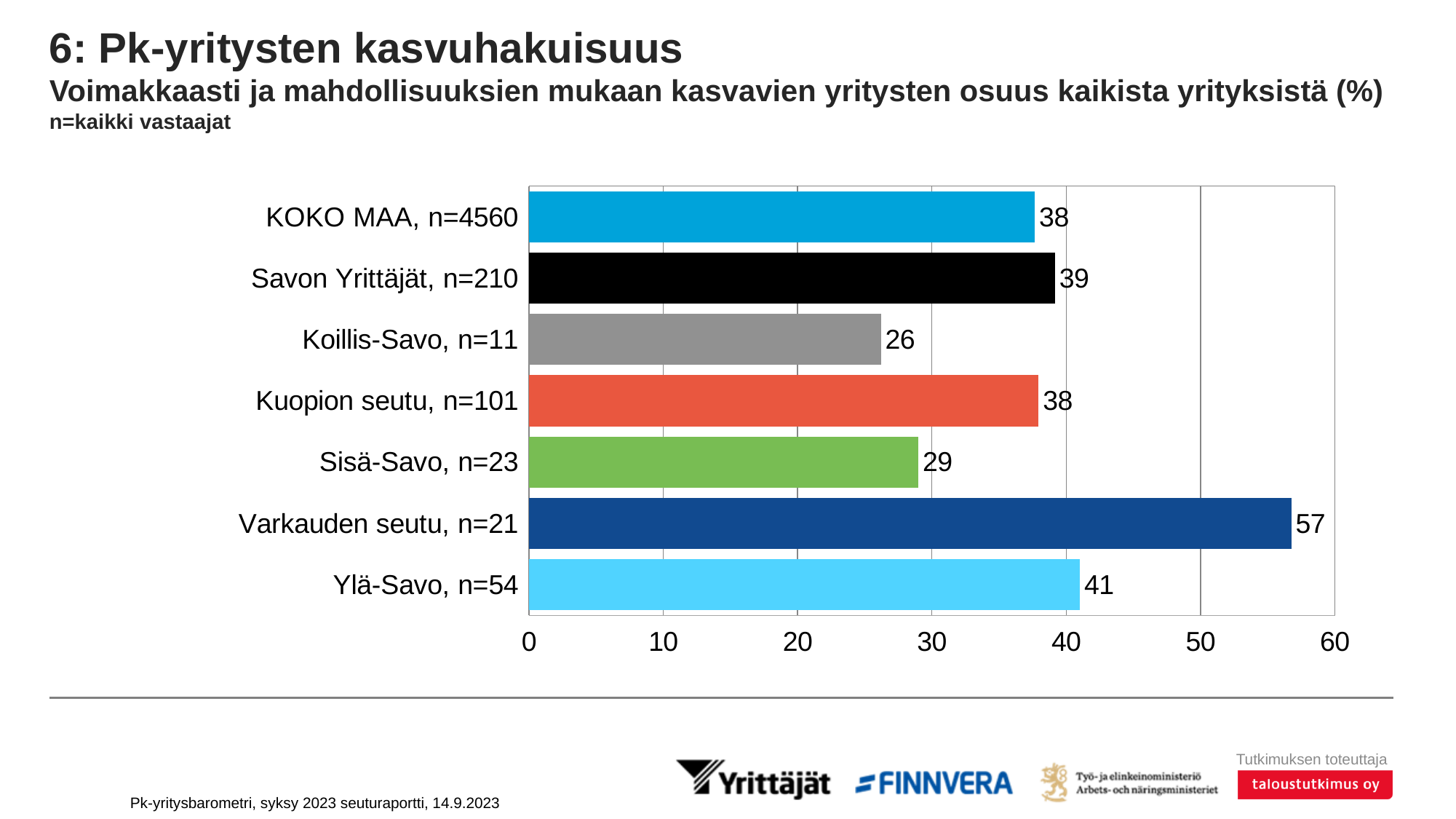
Is the value for Sisä-Savo, n=23 greater or less than 30? less What is the difference between the values for Varkauden seutu, n=21 and Sisä-Savo, n=23? 28 Which is larger, the value for Ylä-Savo, n=54 or the value for Kuopion seutu, n=101? Ylä-Savo, n=54 What is the value for Varkauden seutu, n=21? 57 What is the value for Koillis-Savo, n=11? 26 How many categories are shown in the chart? 7 What is the maximum value shown on the horizontal axis? 60 Which category has the lowest value? Koillis-Savo, n=11 What is the value for Savon Yrittäjät, n=210? 39 What kind of chart is shown on the slide? bar chart Which category has the highest value? Varkauden seutu, n=21 What is the value for Ylä-Savo, n=54? 41